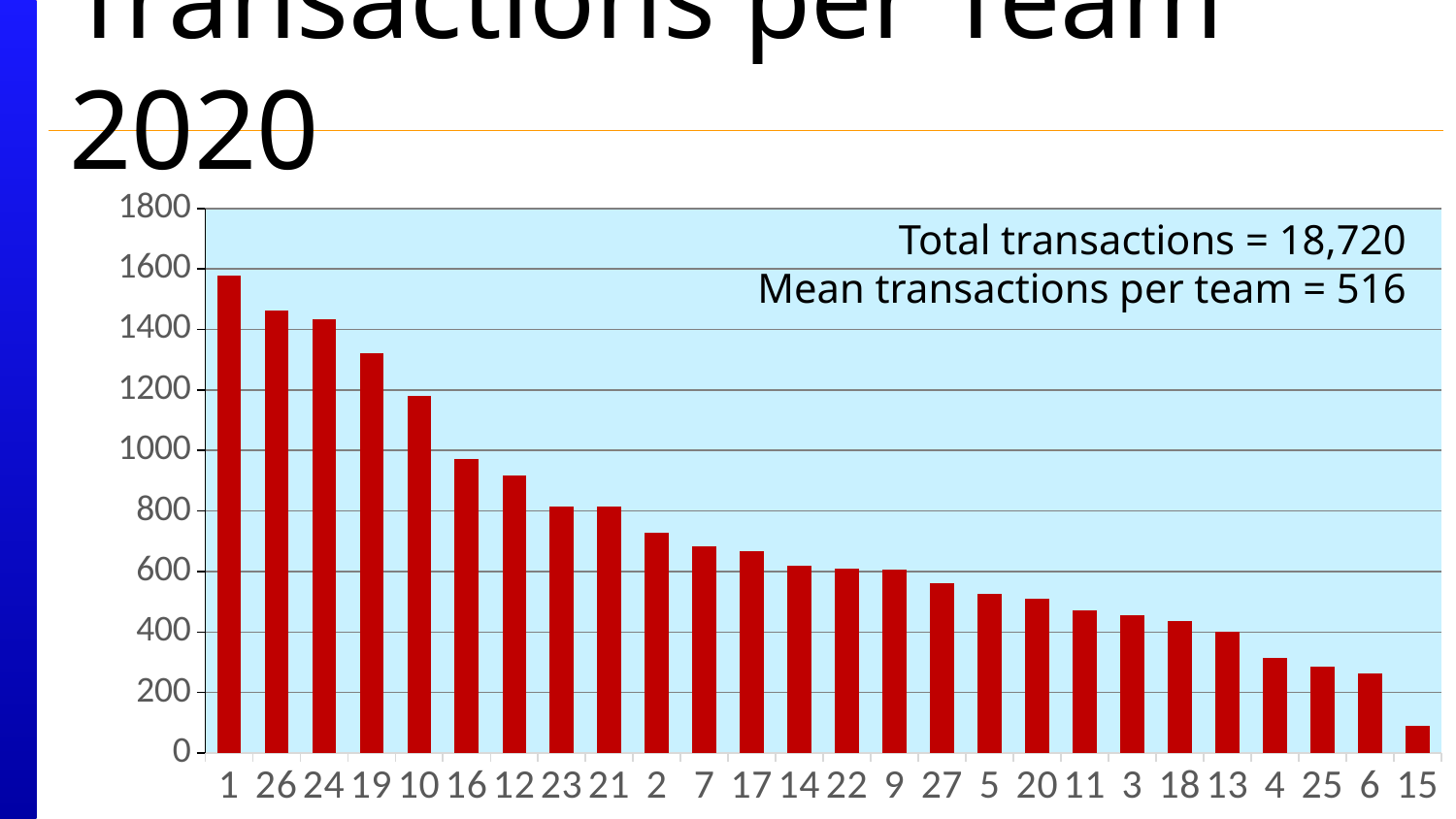
Is the value for team 15 greater or less than 200? less Do the bar values rise or fall from left to right along the x axis? fall Which team has the lowest number of transactions? 15 According to the text on the chart, what is the mean number of transactions per team? 516 Which has more transactions, team 26 or team 19? 26 Is the value for team 1 greater or less than 1400? greater What kind of chart is shown on the slide? bar chart Is the value for team 10 greater or less than 1200? less Which team has the highest number of transactions? 1 How many teams (bars) are shown in the chart? 26 According to the text on the chart, what is the total number of transactions? 18,720